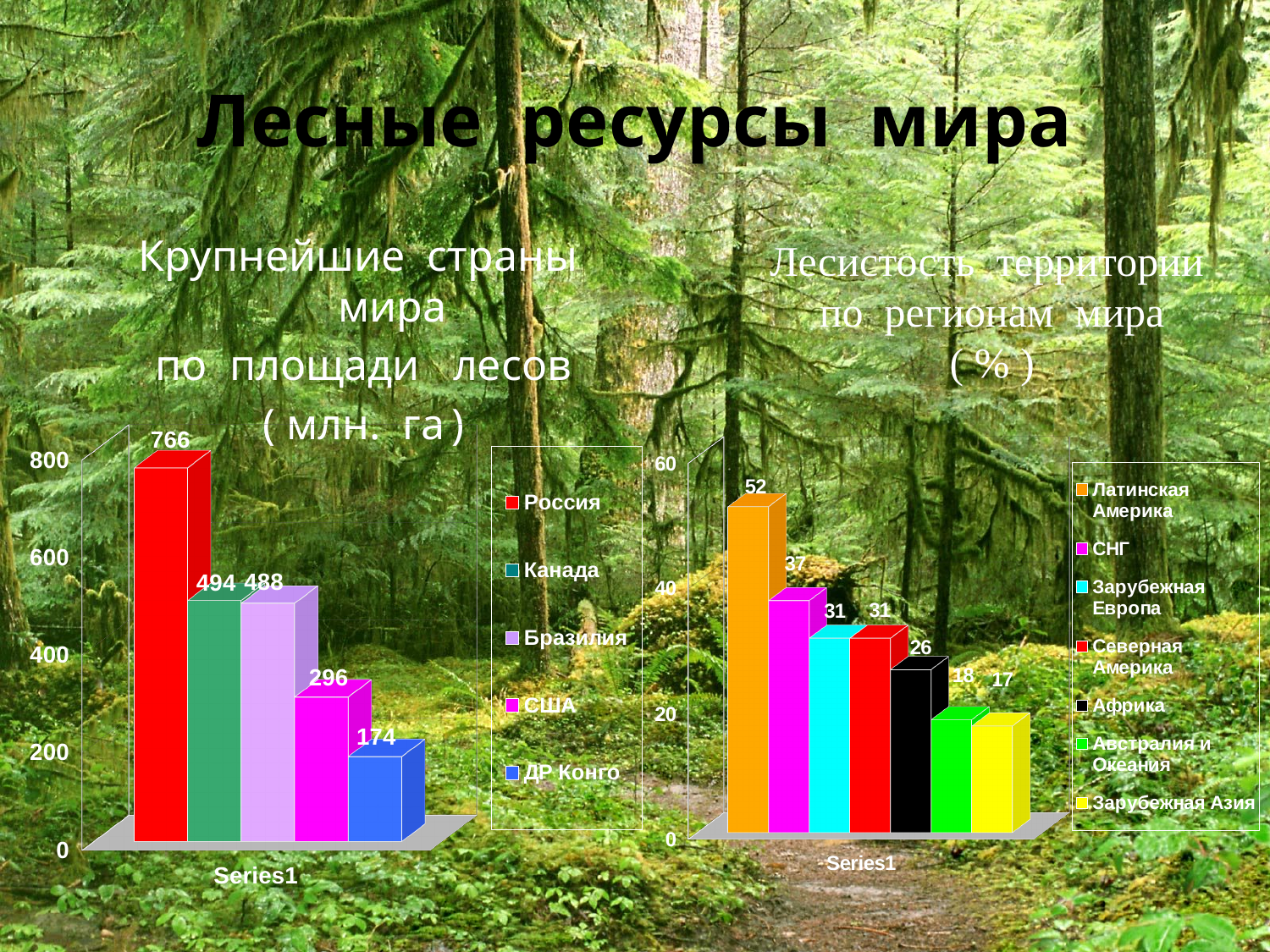
In the right chart (Лесистость территории по регионам мира), how many regions does the legend list? 7 In the right chart (Лесистость территории по регионам мира), what is the value for Африка? 26 What type of chart is the right chart (Лесистость территории по регионам мира)? bar chart In the left chart (Крупнейшие страны мира по площади лесов), is the value for Россия greater or less than 600? greater In the left chart (Крупнейшие страны мира по площади лесов), what is the value for США? 296 In the right chart (Лесистость территории по регионам мира), what is the value for Латинская Америка? 52 In the right chart (Лесистость территории по регионам мира), which is larger, the value for СНГ or the value for Зарубежная Европа? СНГ In the left chart (Крупнейшие страны мира по площади лесов), which country has the lowest value? ДР Конго In the left chart (Крупнейшие страны мира по площади лесов), what is the value for Россия? 766 In the left chart (Крупнейшие страны мира по площади лесов), how many countries are shown? 5 In the left chart (Крупнейшие страны мира по площади лесов), what is the difference between the values for Канада and Бразилия? 6 In the right chart (Лесистость территории по регионам мира), which region has the highest value? Латинская Америка